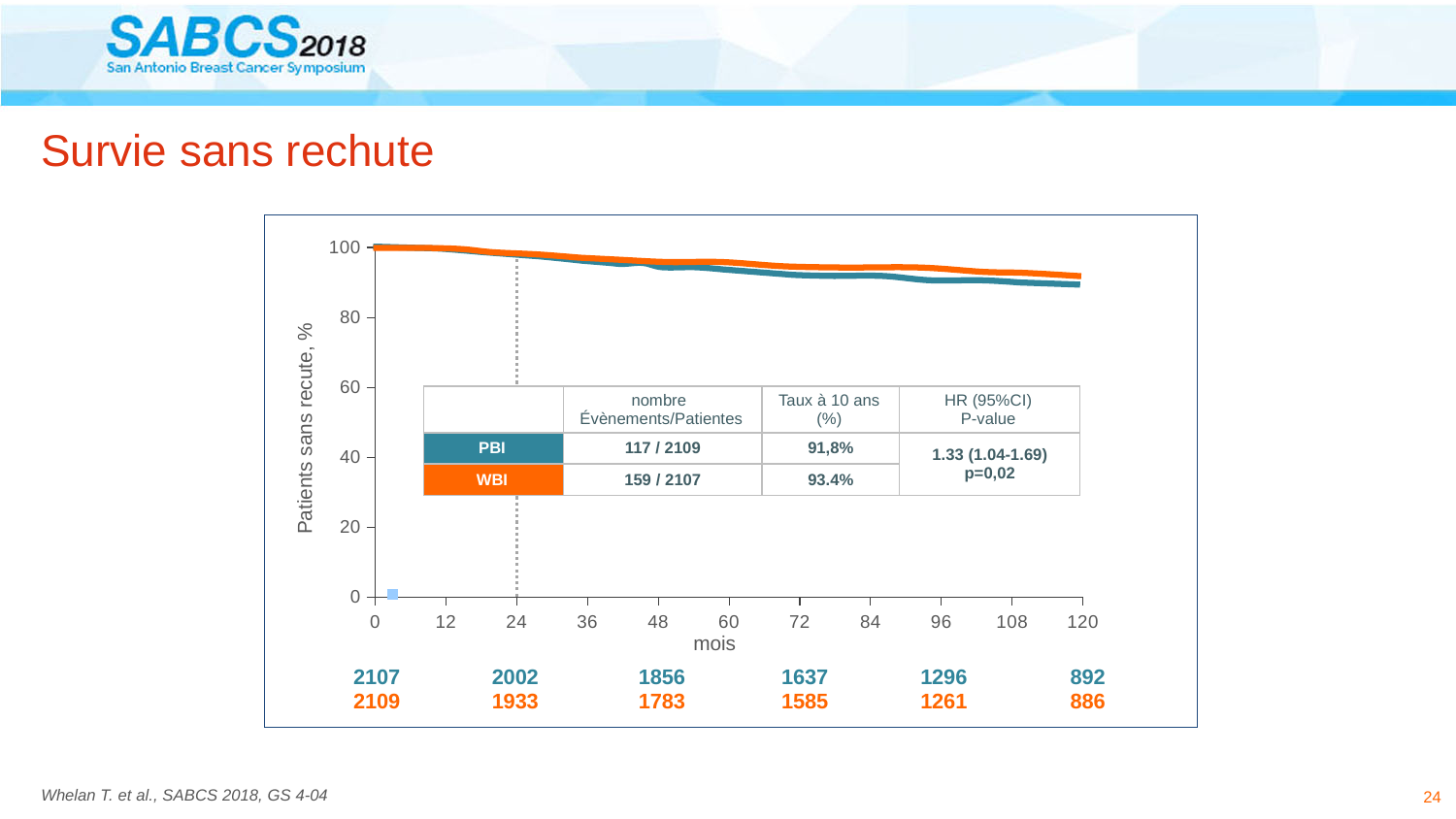
Which group has the higher 10-year rate in the table, PBI or WBI? WBI What is the difference between the 10-year rates of WBI and PBI shown in the table? 1.6 percentage points What kind of chart is shown on the slide? line chart What HR (95%CI) is reported in the table on the chart? 1.33 (1.04-1.69) What is the 'nombre Évènements/Patientes' for WBI in the table on the chart? 159 / 2107 Do the survival curves rise or fall as the months increase along the x axis? fall According to the table on the chart, what is the 'Taux à 10 ans (%)' for WBI? 93.4% What is the label of the x axis of the chart? mois What is the 'nombre Évènements/Patientes' for PBI in the table on the chart? 117 / 2109 According to the table on the chart, what is the 'Taux à 10 ans (%)' for PBI? 91,8% At 120 months, is the value of the orange curve greater or less than 80? greater What is the label of the y axis of the chart? Patients sans recute, %